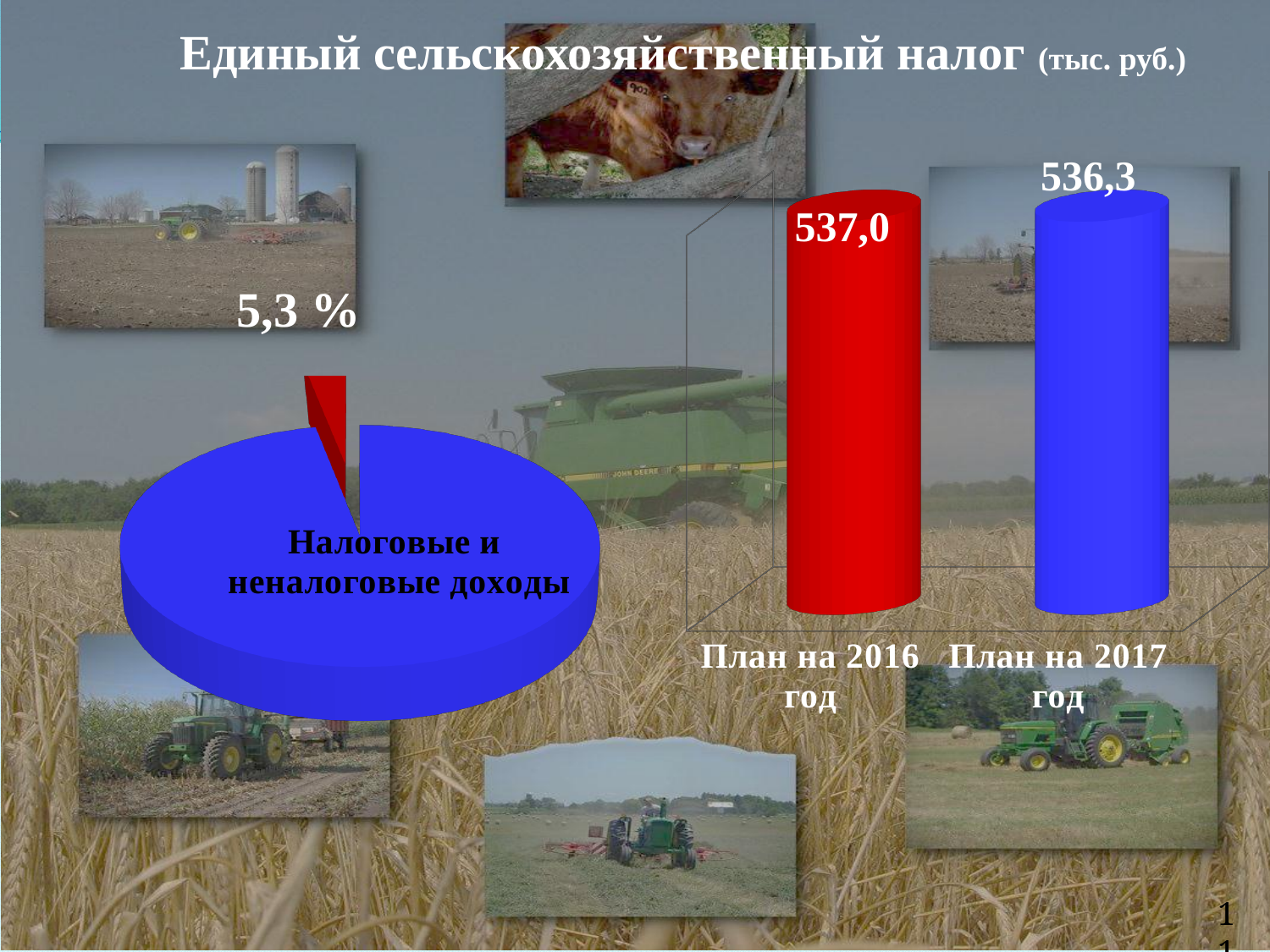
What kind of chart is shown on the left side of the slide? Pie chart What kind of chart is shown on the right side of the slide? Bar chart On the bar chart, which category has the higher value? План на 2016 год On the bar chart, how many bars are plotted? 2 On the bar chart, what is the value for План на 2016 год? 537,0 What unit is given in the slide title for the values? тыс. руб. On the bar chart, do the values rise or fall from План на 2016 год to План на 2017 год? Fall On the bar chart, what is the difference between the values for План на 2016 год and План на 2017 год? 0,7 On the bar chart, which category has the lower value? План на 2017 год On the pie chart, what is the label of the large blue slice? Налоговые и неналоговые доходы On the bar chart, what is the value for План на 2017 год? 536,3 On the pie chart, what share is shown for the red slice? 5,3 %